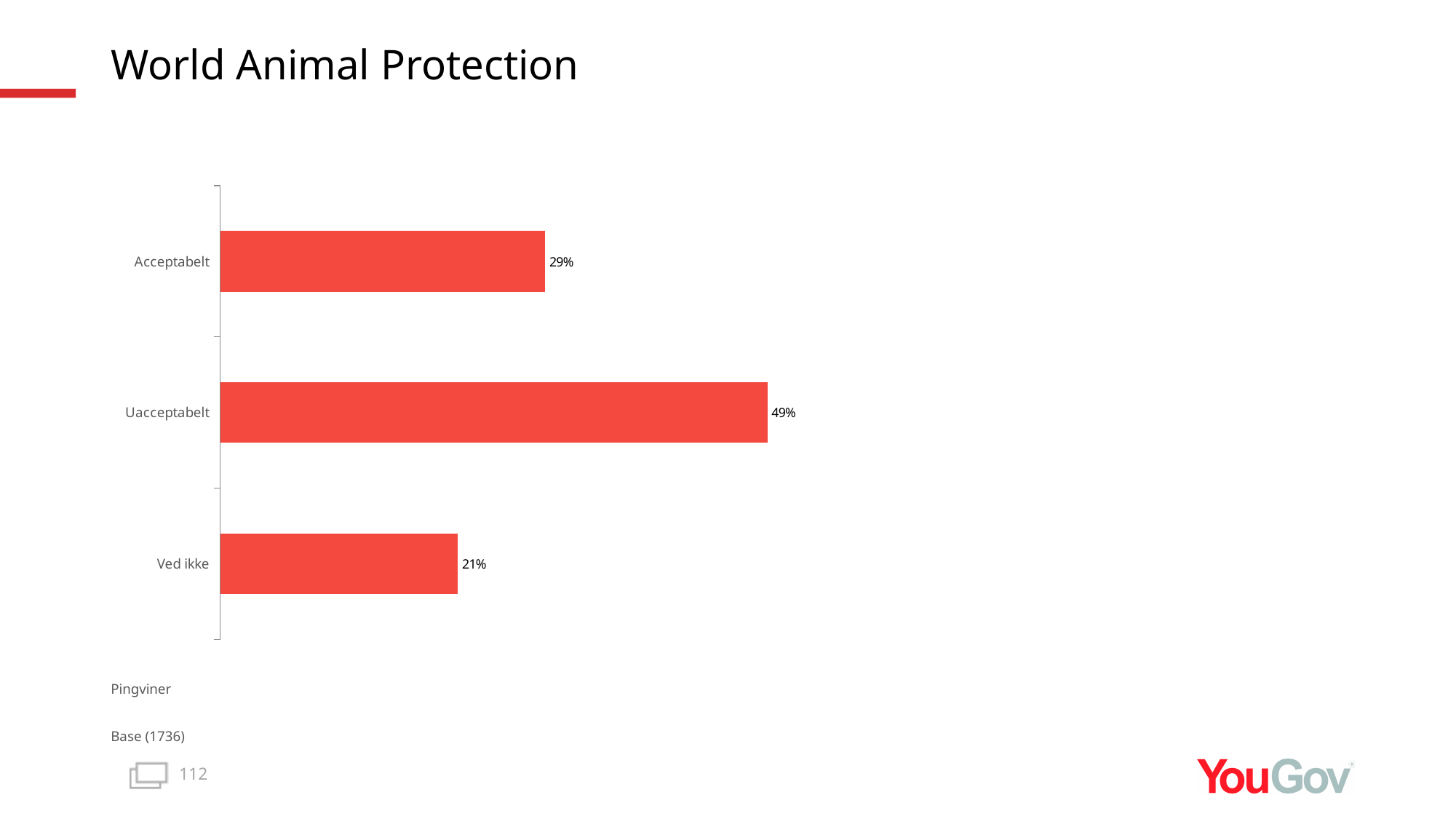
What is the title of the slide? World Animal Protection What is the difference in percentage points between "Uacceptabelt" and "Acceptabelt"? 20 Which response category has the lowest percentage? Ved ikke How many response categories are shown in the chart? 3 What base size is stated below the chart? 1736 What percentage of respondents answered "Ved ikke"? 21% What percentage of respondents answered "Uacceptabelt"? 49% What type of chart is shown on the slide? Bar chart What percentage of respondents answered "Acceptabelt"? 29% Which is larger, the value for "Acceptabelt" or the value for "Ved ikke"? Acceptabelt Which response category has the highest percentage? Uacceptabelt What is the difference in percentage points between "Acceptabelt" and "Ved ikke"? 8